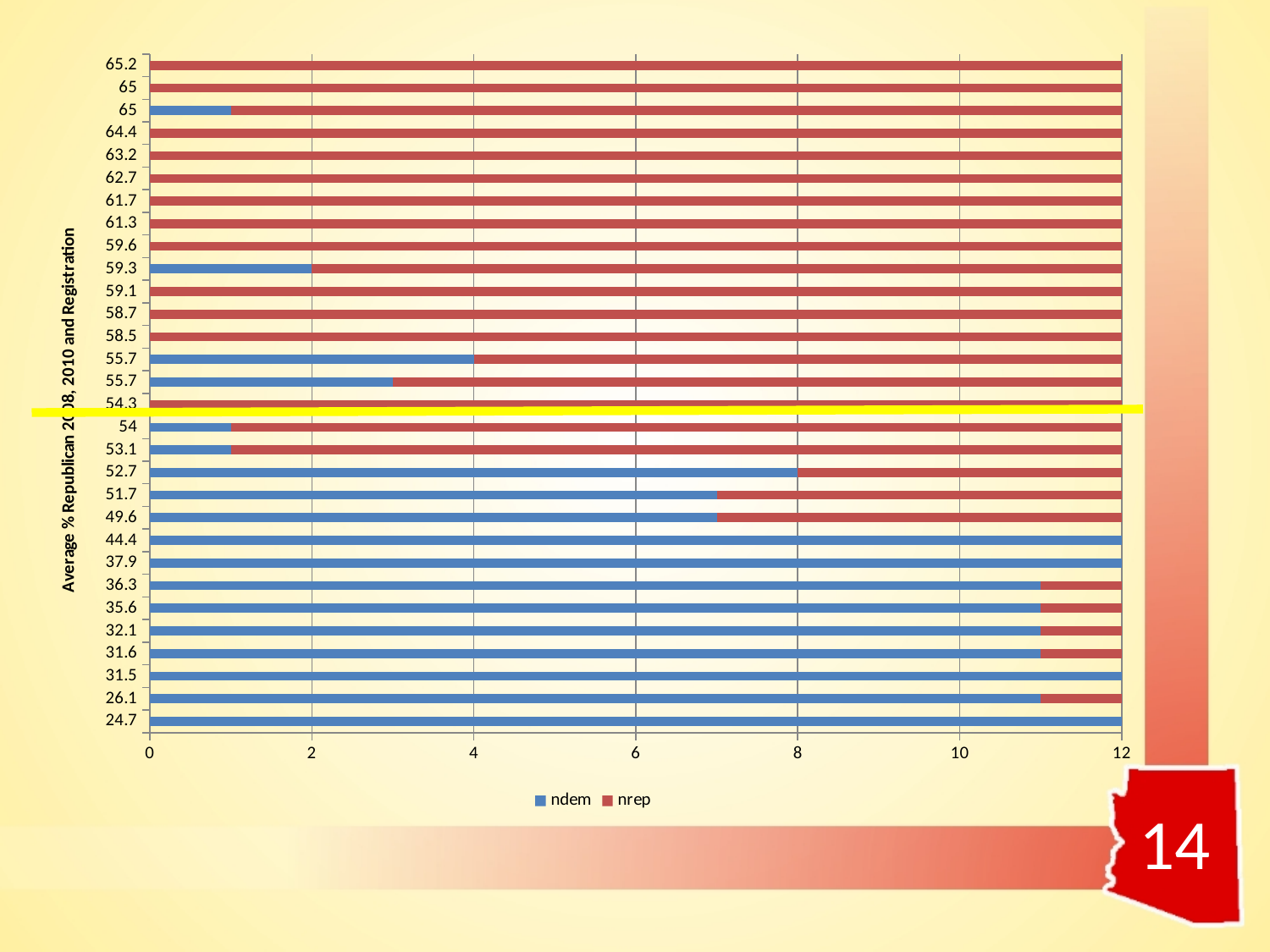
What is the ndem value for the category labelled 52.7? 8 What are the two series named in the legend? ndem and nrep Which has the larger ndem value: the category labelled 52.7 or the category labelled 59.3? 52.7 What is the ndem value for the category labelled 44.4? 12 What kind of chart is shown on the slide? bar chart Which colour represents the ndem series? blue How many series does the legend list? 2 How many categories are plotted on the vertical axis? 30 What is the ndem value for the category labelled 59.3? 2 Is the ndem value for the category labelled 51.7 greater or less than 6? greater Is the nrep value for the category labelled 36.3 greater or less than 2? less What is the nrep value for the category labelled 65.2? 12